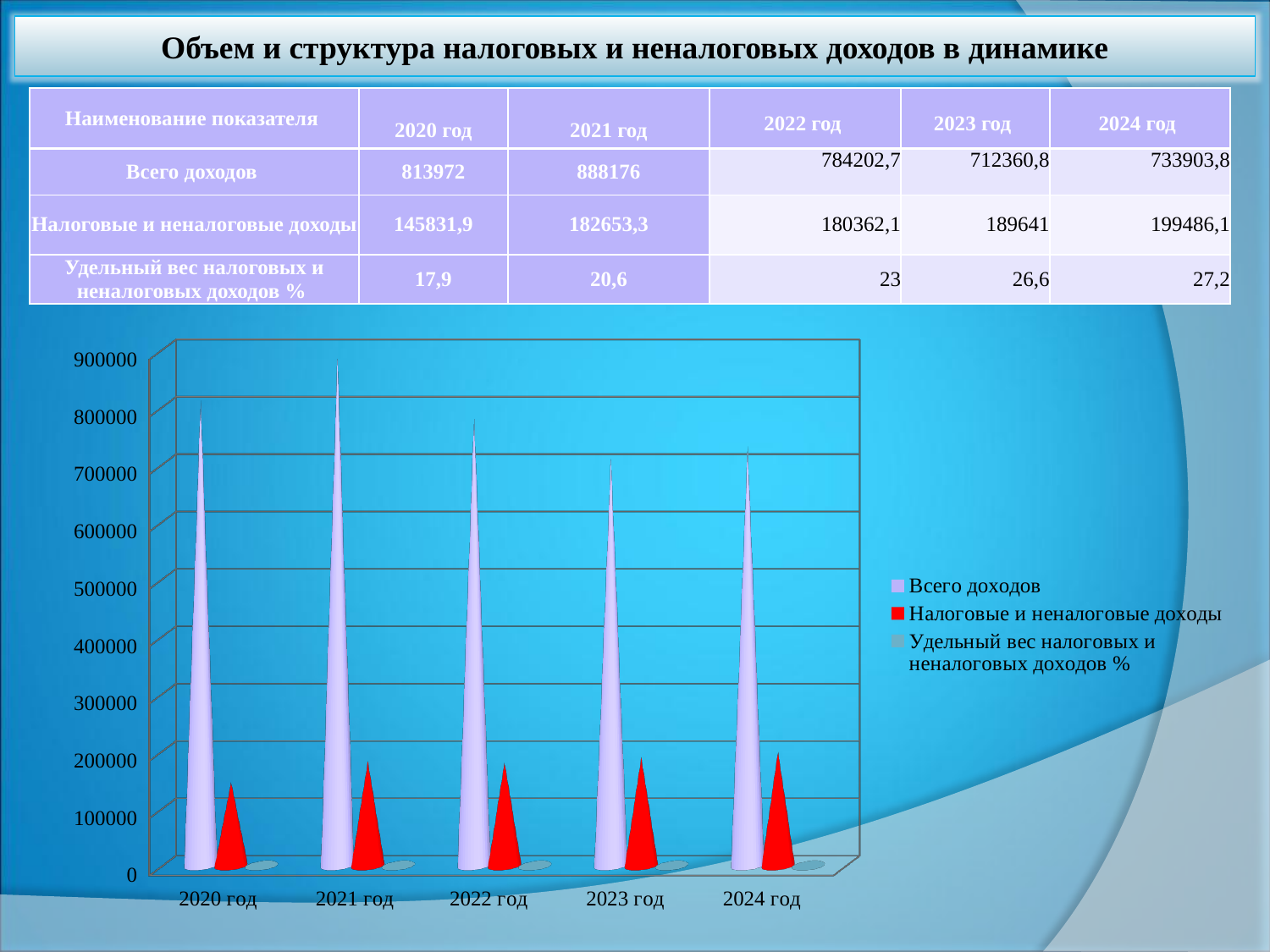
Which is larger, Всего доходов for 2022 год or for 2023 год? 2022 год Which year has the highest value for Налоговые и неналоговые доходы? 2024 год How many year categories are shown on the x axis of the chart? 5 What colour represents Налоговые и неналоговые доходы in the chart? red Which year has the lowest value for Налоговые и неналоговые доходы? 2020 год What is the value of Всего доходов for 2021 год? 888176 What kind of chart is shown on the slide? bar chart Which year has the lowest value for Всего доходов? 2023 год What is the value of Налоговые и неналоговые доходы for 2024 год? 199486,1 Which year has the highest value for Всего доходов? 2021 год Is the value of Всего доходов for 2023 год greater or less than 800000? less How many series does the chart legend list? 3